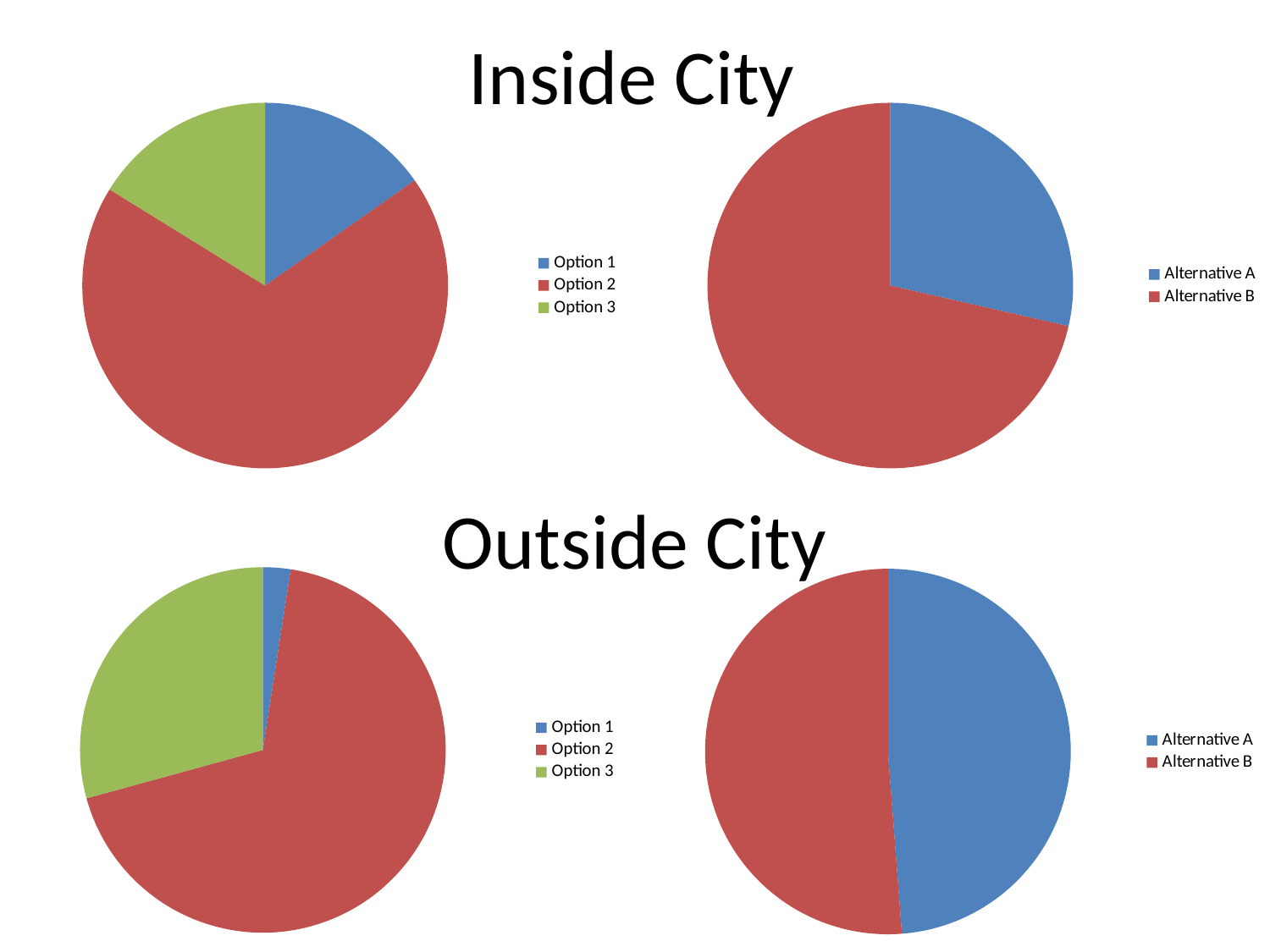
In the top-right pie chart under "Inside City", how many entries does the legend list? 2 In the bottom-left pie chart under "Outside City", which option has the largest slice? Option 2 In the bottom-left pie chart under "Outside City", which option has the smallest slice? Option 1 How many pie charts are shown on the slide? 4 In the bottom-left pie chart under "Outside City", which slice is larger, Option 1 or Option 3? Option 3 In the top-left pie chart under "Inside City", which option has the largest slice? Option 2 In the bottom-right pie chart under "Outside City", what colour represents Alternative A? Blue What are the two titles shown on the slide? Inside City and Outside City In the top-left pie chart under "Inside City", which slice is larger, Option 2 or Option 3? Option 2 In the top-left pie chart under "Inside City", how many slices does the pie have? 3 In the top-right pie chart under "Inside City", which alternative has the larger slice? Alternative B What kind of chart is the top-left chart under "Inside City"? Pie chart